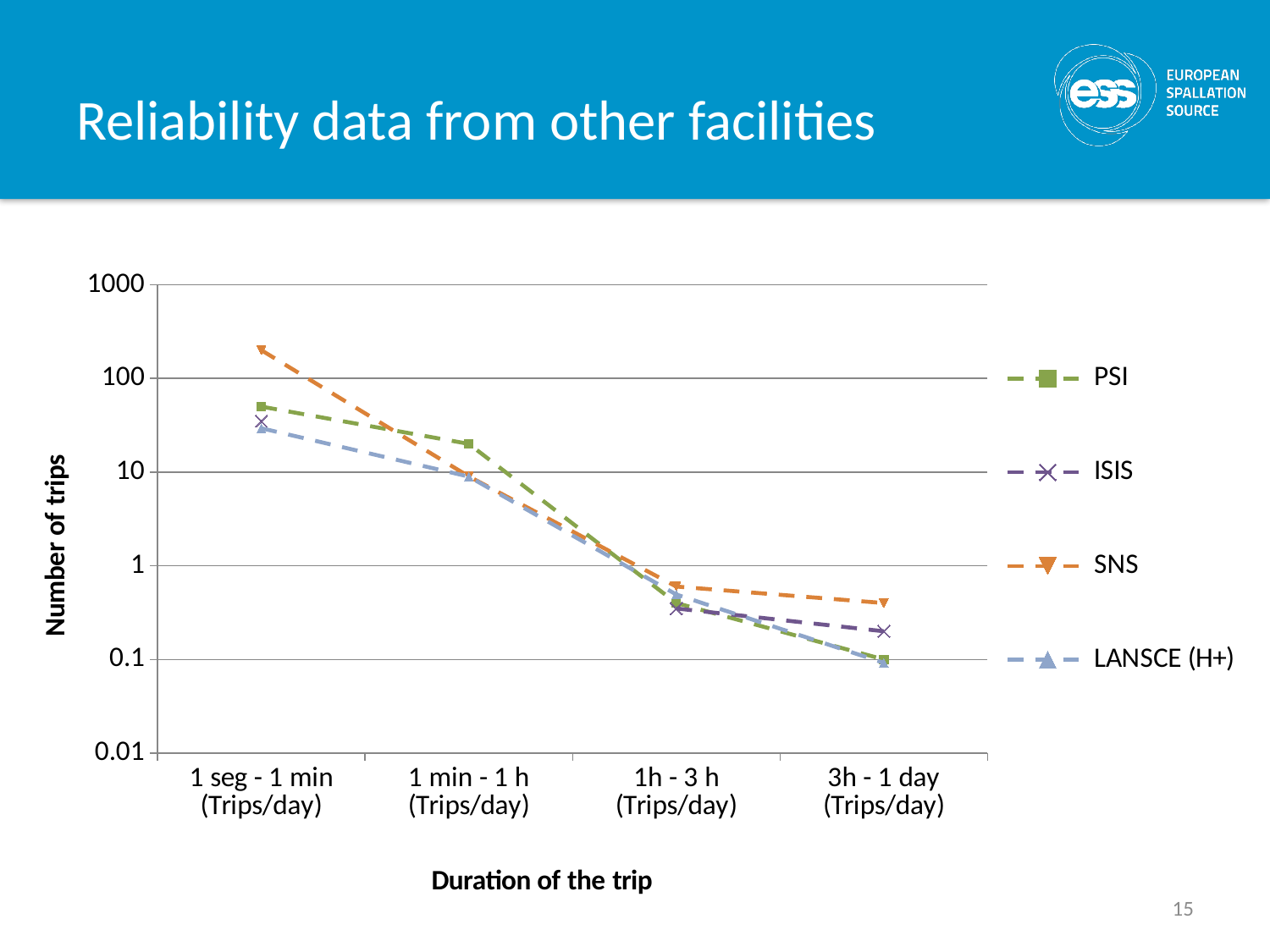
Which series has the highest number of trips in the '1 seg - 1 min (Trips/day)' category? SNS How many trip-duration categories are shown on the x axis? 4 What is the title of the vertical axis? Number of trips In the '1 seg - 1 min (Trips/day)' category, which is larger, the value for SNS or the value for PSI? SNS How many series does the legend list? 4 Do the values for SNS rise or fall along the x axis from '1 seg - 1 min' to '3h - 1 day'? fall Is the value for ISIS in the '3h - 1 day (Trips/day)' category greater or less than 1? less Which series has the highest number of trips in the '3h - 1 day (Trips/day)' category? SNS Is the value for PSI in the '1 seg - 1 min (Trips/day)' category greater or less than 100? less What kind of chart is shown on the slide? line chart Is the value for PSI in the '1 min - 1 h (Trips/day)' category greater or less than 10? greater